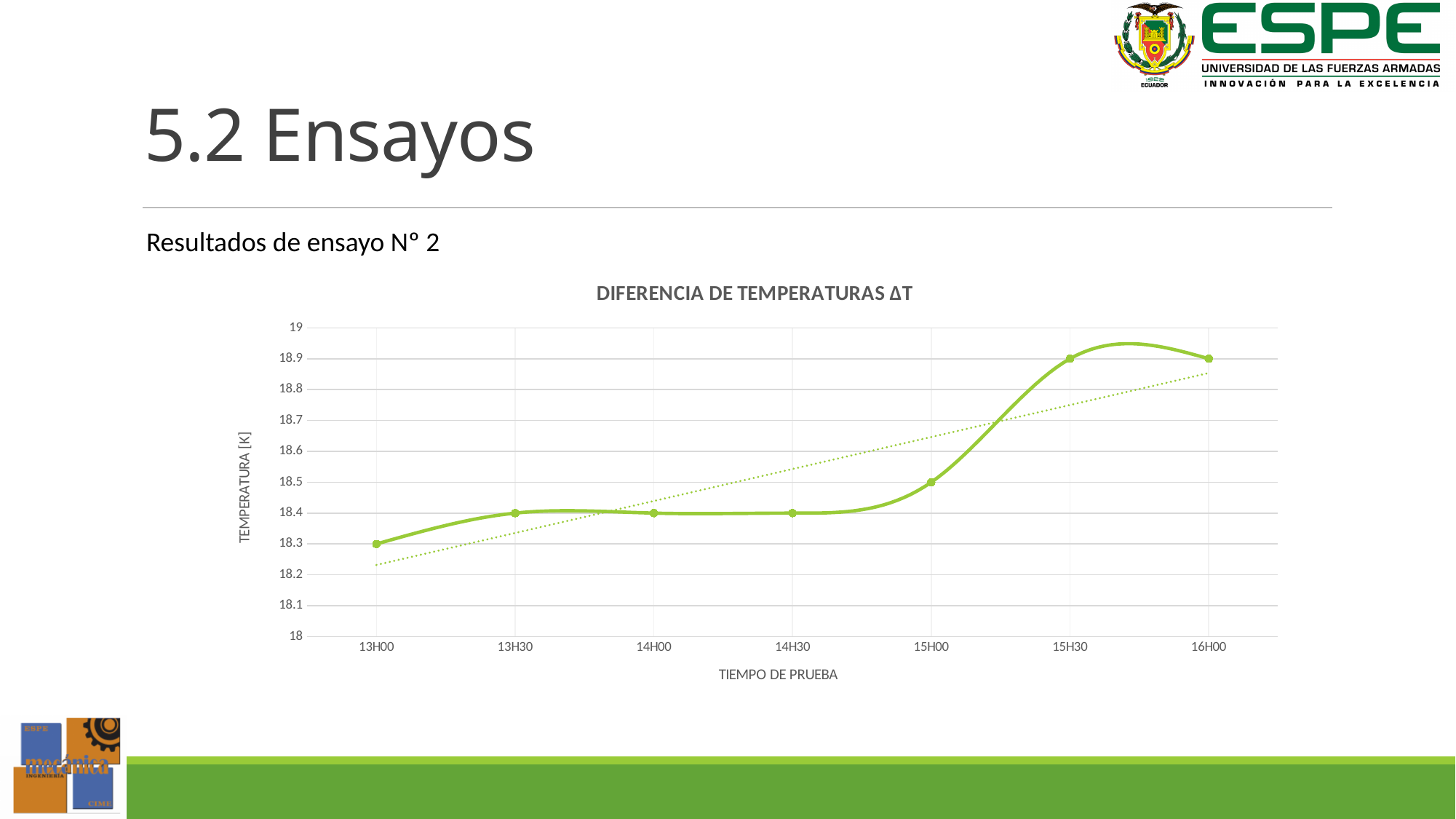
What is the temperature value at 15H30? 18.9 How many data points are plotted on the line? 7 What is the difference between the temperature at 15H30 and at 13H00? 0.6 What kind of chart is shown on the slide? line chart What is the label of the x axis? TIEMPO DE PRUEBA Which is larger, the temperature at 15H00 or at 14H30? 15H00 What is the temperature value at 14H00? 18.4 What is the temperature value at 15H00? 18.5 What is the temperature value at 13H00? 18.3 Do the temperature values generally rise or fall from 13H00 to 16H00? rise At which time is the temperature lowest? 13H00 What is the title of the chart? DIFERENCIA DE TEMPERATURAS ΔT